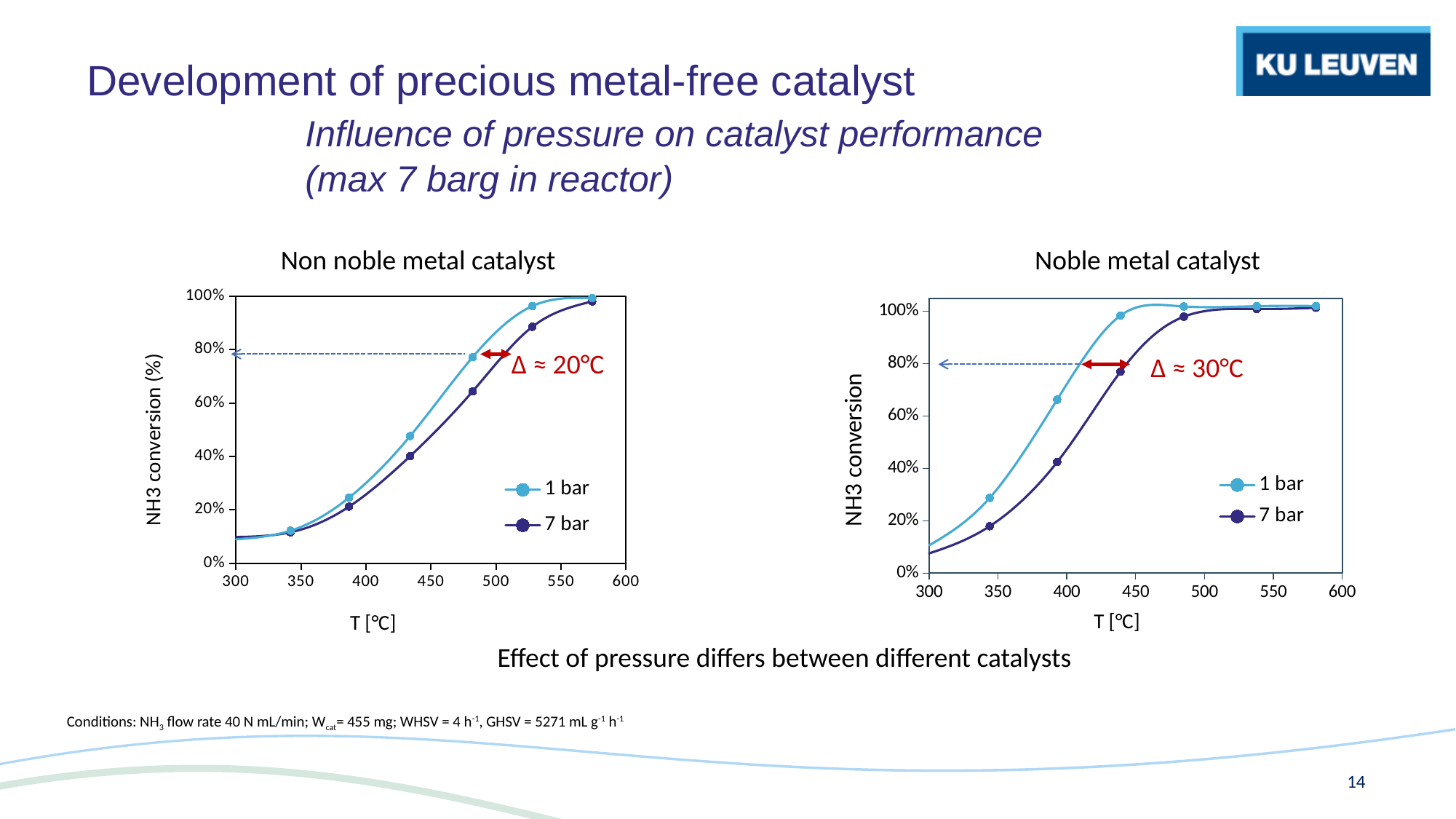
How many series does the legend of the 'Noble metal catalyst' chart list? 2 In the 'Noble metal catalyst' chart, at around 440°C, which series has the higher NH3 conversion, 1 bar or 7 bar? 1 bar In the 'Non noble metal catalyst' chart, at around 480°C, which series has the higher NH3 conversion, 1 bar or 7 bar? 1 bar In the 'Non noble metal catalyst' chart, does NH3 conversion rise or fall as temperature increases? rise What kind of chart is the 'Non noble metal catalyst' chart? line chart In the 'Noble metal catalyst' chart, does NH3 conversion rise or fall as temperature increases? rise In the 'Noble metal catalyst' chart, how many data points are plotted for the 7 bar series? 6 What temperature shift is annotated in red on the 'Noble metal catalyst' chart? Δ ≈ 30°C In the 'Noble metal catalyst' chart, is the 7 bar NH3 conversion at around 390°C greater or less than 60%? less In the 'Non noble metal catalyst' chart, what are the two legend entries? 1 bar and 7 bar In the 'Non noble metal catalyst' chart, how many data points are plotted for the 1 bar series? 6 In the 'Non noble metal catalyst' chart, is the 1 bar NH3 conversion at around 530°C greater or less than 80%? greater